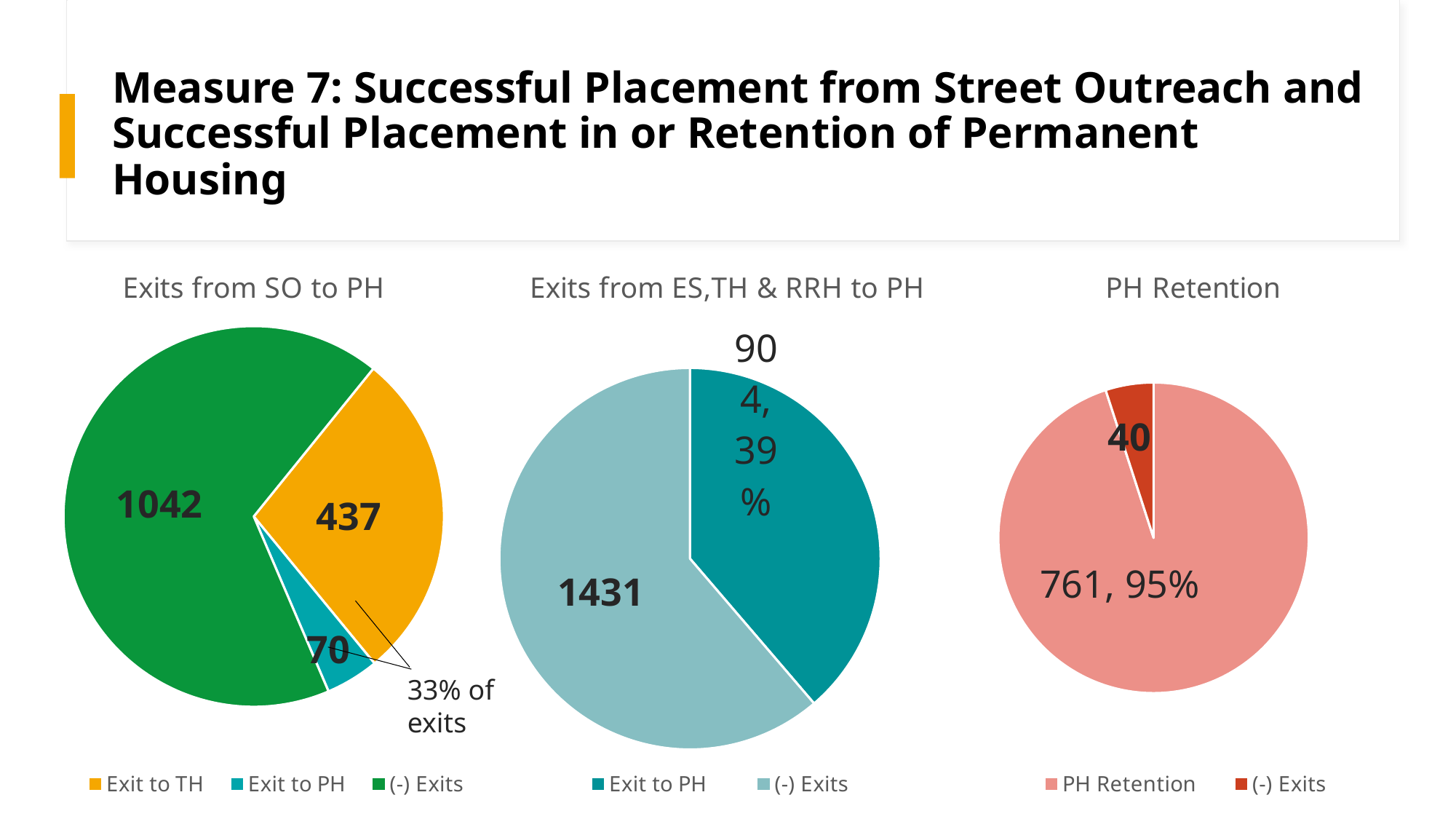
In the 'Exits from SO to PH' chart, what is the difference between (-) Exits and Exit to TH? 605 In the 'Exits from SO to PH' chart, which category has the largest slice? (-) Exits In the 'Exits from SO to PH' chart, what is the value for Exit to PH? 70 In the 'PH Retention' chart, what is the value for (-) Exits? 40 In the 'Exits from ES,TH & RRH to PH' chart, which is larger, Exit to PH or (-) Exits? (-) Exits In the 'Exits from ES,TH & RRH to PH' chart, what is the value for (-) Exits? 1431 In the 'Exits from ES,TH & RRH to PH' chart, what percentage share does Exit to PH have? 39% In the 'Exits from SO to PH' chart, which category has the smallest slice? Exit to PH In the 'Exits from SO to PH' chart, what is the value for Exit to TH? 437 In the 'PH Retention' chart, what is the difference between PH Retention and (-) Exits? 721 In the 'PH Retention' chart, what percentage share does PH Retention have? 95% How many categories does the legend of the 'Exits from SO to PH' chart list? 3